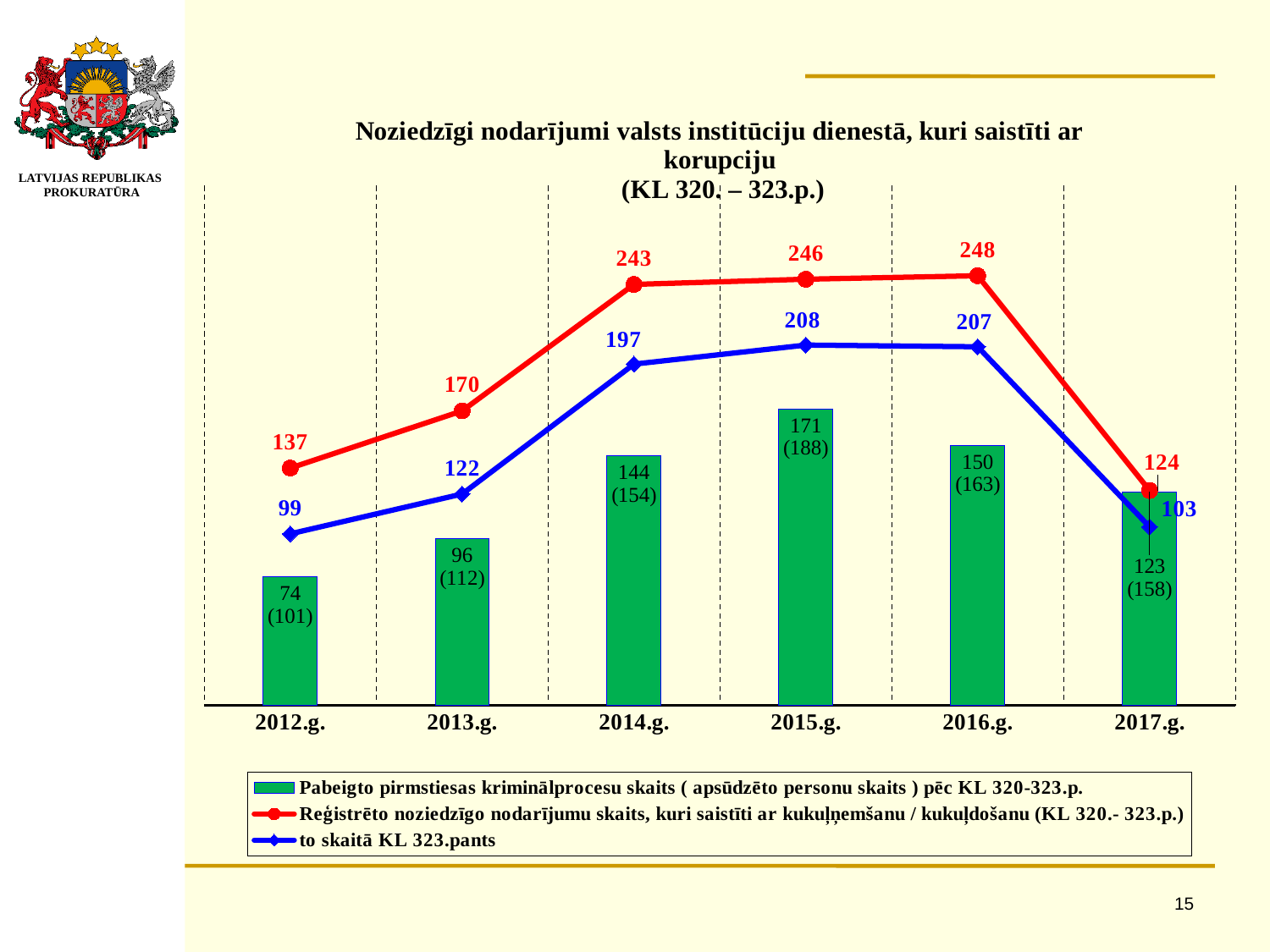
What is the value of the blue line (to skaitā KL 323.pants) for 2015.g.? 208 What number of accused persons is shown in parentheses on the bar for 2016.g.? 163 What is the difference between the red line value and the blue line value in 2017.g.? 21 In which year does the red line reach its highest value? 2016.g. How many series does the legend list? 3 What kind of chart is this? Combined bar and line chart How many years are shown on the x axis? 6 What is the value of the red line (Reģistrēto noziedzīgo nodarījumu skaits) for 2014.g.? 243 Does the blue line rise or fall from 2016.g. to 2017.g.? Fall What is the bar value (Pabeigto pirmstiesas kriminālprocesu skaits) for 2012.g.? 74 Which is larger: the bar value for 2015.g. or the bar value for 2016.g.? 2015.g. In which year is the green bar the lowest? 2012.g.